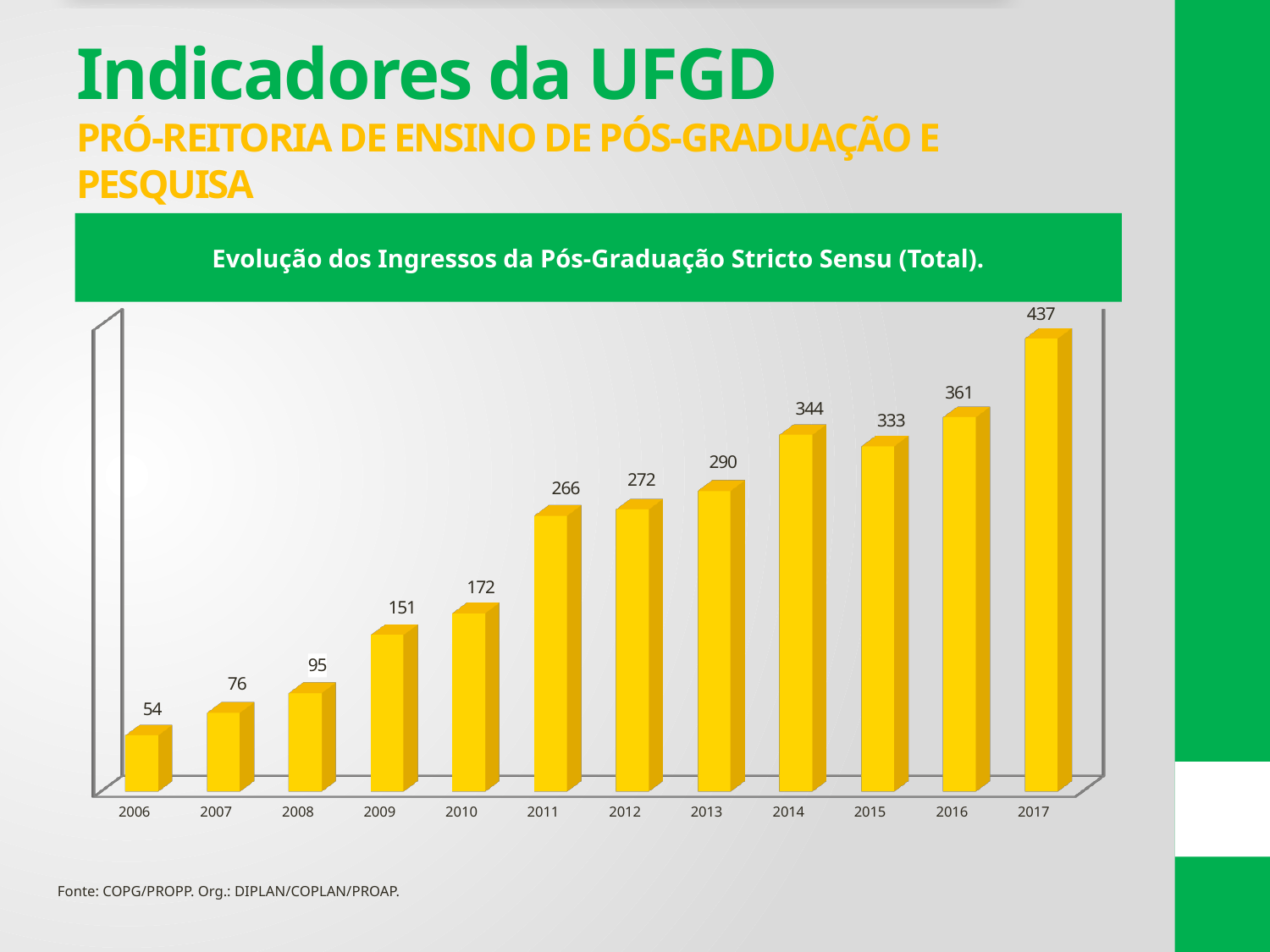
What is the title of the chart? Evolução dos Ingressos da Pós-Graduação Stricto Sensu (Total). What kind of chart is this? bar chart What is the difference between the values for 2014 and 2015? 11 Which is larger, the value for 2014 or the value for 2015? 2014 What is the value for 2015? 333 Do the values generally rise or fall from 2006 to 2017? rise What is the value for 2006? 54 Which year has the lowest value? 2006 What is the value for 2010? 172 Which year has the highest value? 2017 How many years are shown on the x axis? 12 What is the difference between the values for 2017 and 2016? 76